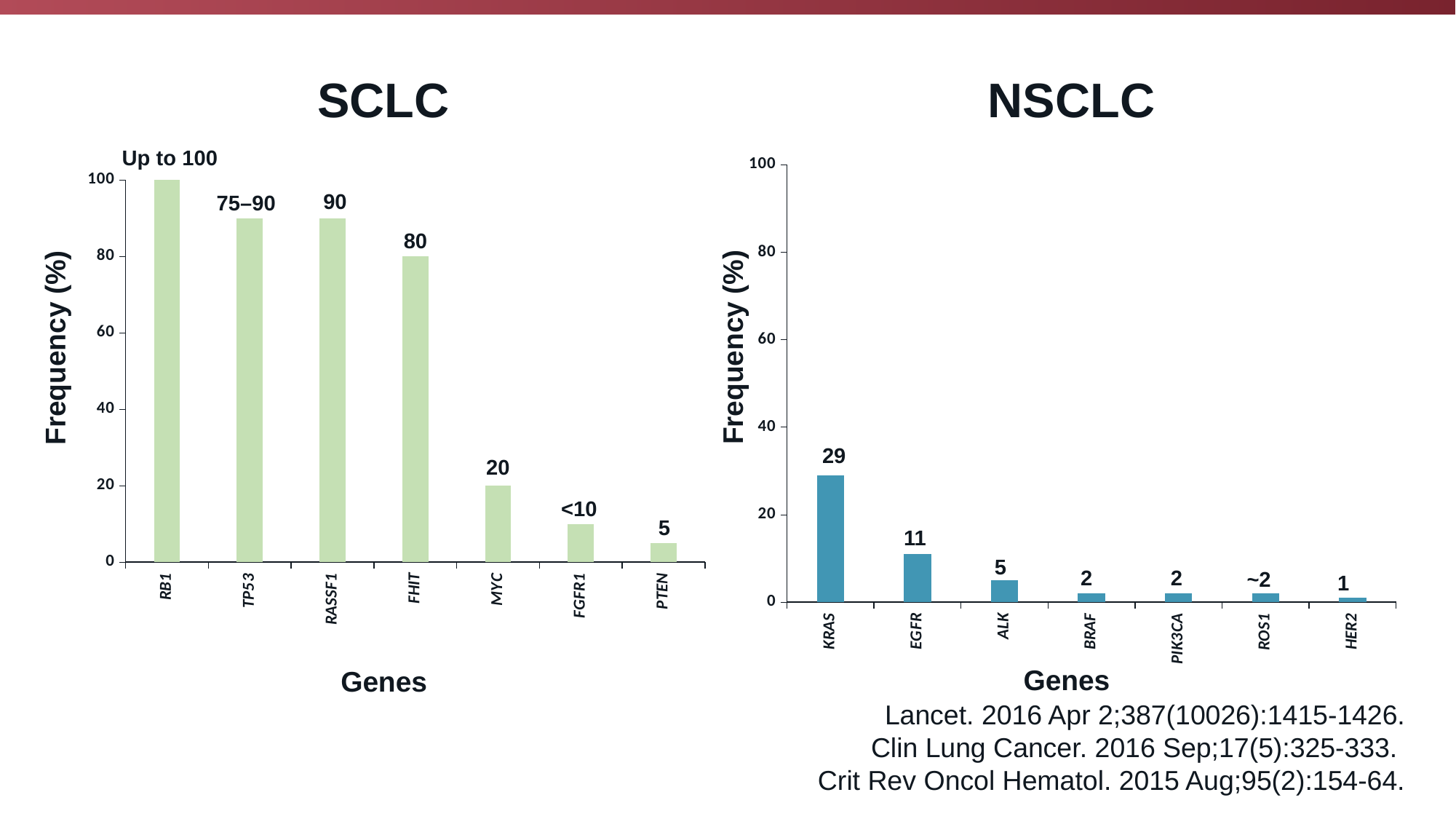
In the NSCLC chart, which gene has the lowest frequency? HER2 In the SCLC chart, which has a higher frequency, FHIT or MYC? FHIT In the NSCLC chart, what is the frequency (%) for KRAS? 29 In the SCLC chart, what is the difference in frequency (%) between RASSF1 and FHIT? 10 How many genes are shown in the NSCLC chart? 7 In the NSCLC chart, which gene has the highest frequency? KRAS What kind of chart is the SCLC chart? Bar chart In the SCLC chart, what is the frequency (%) for PTEN? 5 In the SCLC chart, what is the frequency (%) for FHIT? 80 In the NSCLC chart, what is the difference in frequency (%) between KRAS and EGFR? 18 In the SCLC chart, what is the frequency (%) for RASSF1? 90 In the NSCLC chart, what is the frequency (%) for EGFR? 11